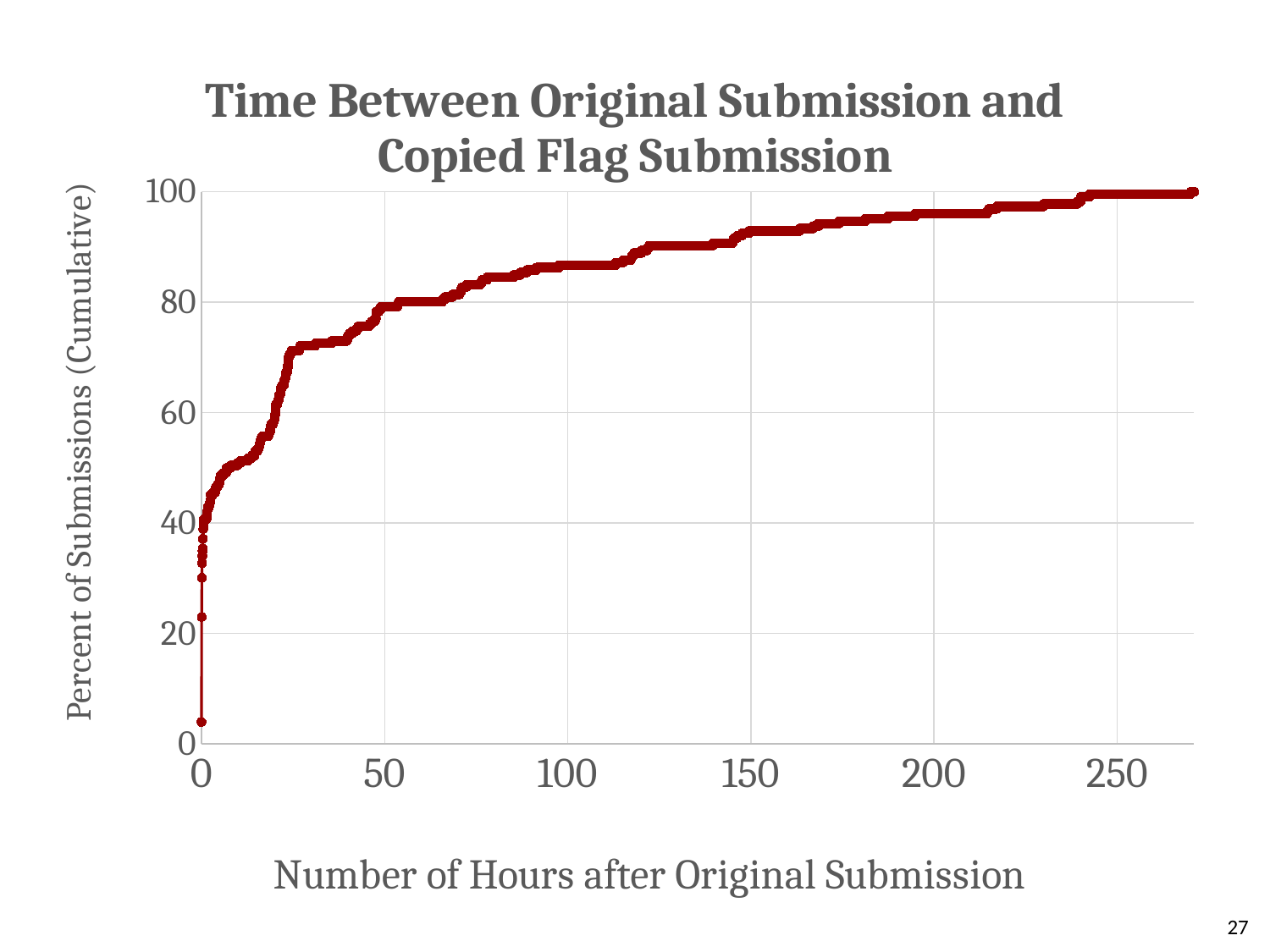
Is the cumulative percent at 25 hours greater or less than 80? less Is the cumulative percent at 200 hours greater or less than 80? greater What kind of chart is shown on the slide? line chart Is the cumulative percent at 100 hours greater or less than 80? greater What is the label of the x axis? Number of Hours after Original Submission What is the title of the chart? Time Between Original Submission and Copied Flag Submission Do the plotted values rise or fall as the number of hours increases? rise Which is larger, the cumulative percent at 100 hours or at 200 hours? 200 hours